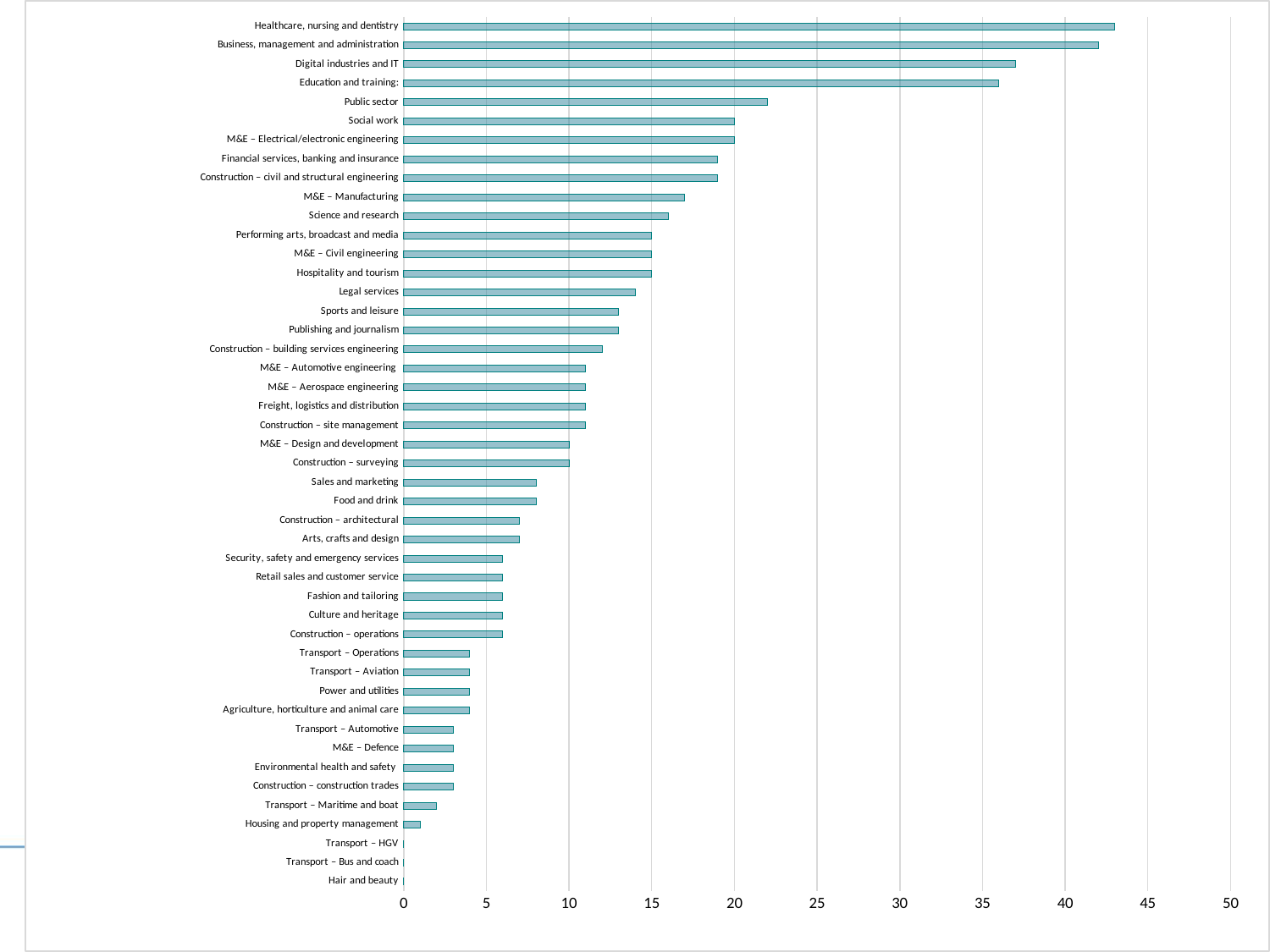
Which category has the longest bar on the chart? Healthcare, nursing and dentistry Do the bar values rise or fall moving from the top category to the bottom category? fall Is the value for Housing and property management greater or less than 5? less Which has the larger value, Science and research or Legal services? Science and research Is the value for Healthcare, nursing and dentistry greater or less than 40? greater What kind of chart is shown on the slide? bar chart Which has the larger value, Public sector or Social work? Public sector Is the value for Public sector greater or less than 20? greater How many categories are plotted on the chart? 46